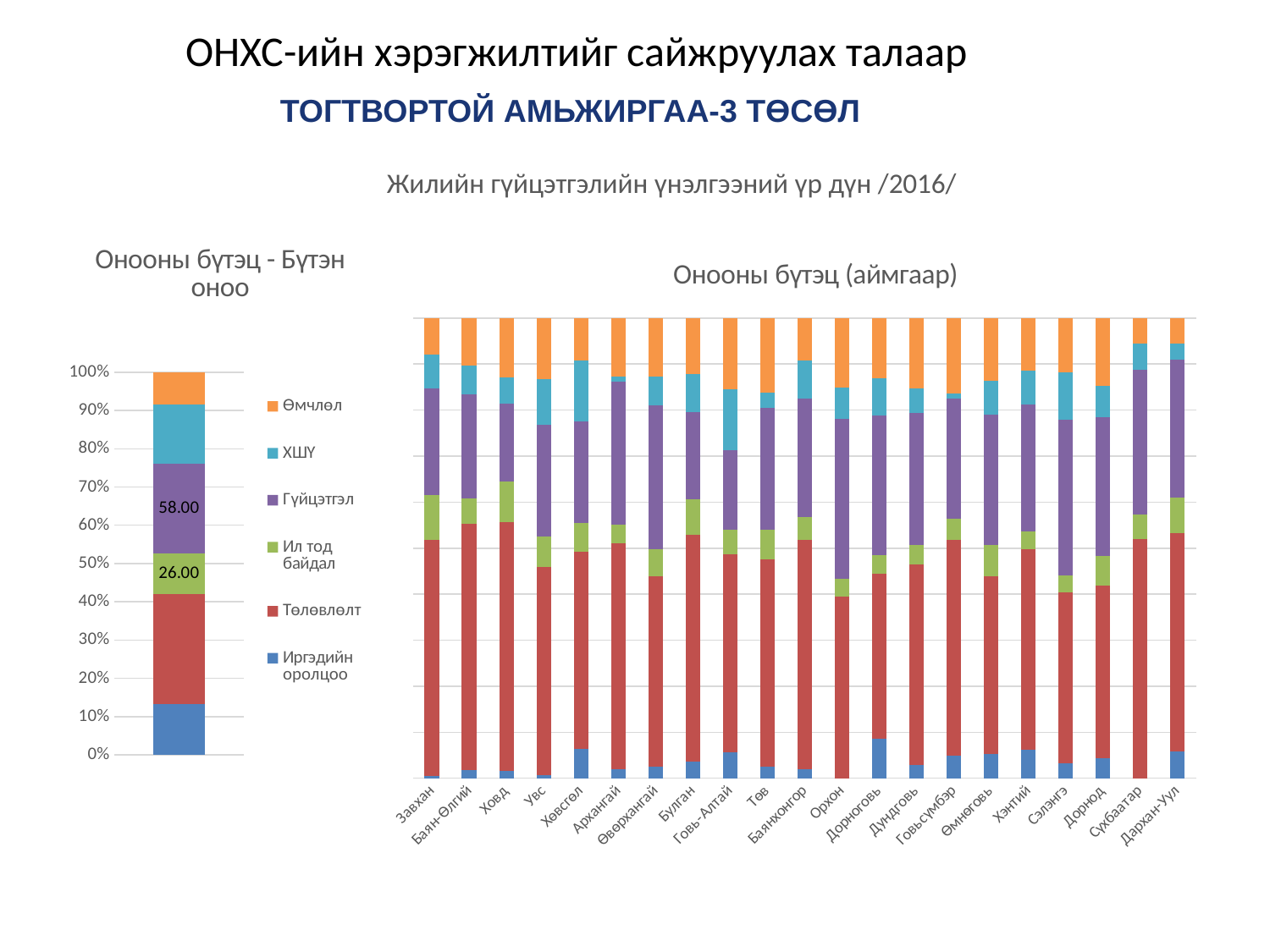
In the chart titled "Онооны бүтэц - Бүтэн оноо", what value is labelled on the Гүйцэтгэл segment? 58.00 In the chart titled "Онооны бүтэц - Бүтэн оноо", which legend entry is shown in orange? Өмчлөл What kind of chart is the chart titled "Онооны бүтэц (аймгаар)"? Stacked bar chart In the chart titled "Онооны бүтэц - Бүтэн оноо", which labelled segment is larger, Гүйцэтгэл or Ил тод байдал? Гүйцэтгэл In the chart titled "Онооны бүтэц - Бүтэн оноо", is the Иргэдийн оролцоо segment greater or less than 10%? greater How many series does the legend of the chart titled "Онооны бүтэц - Бүтэн оноо" list? 6 In the chart titled "Онооны бүтэц - Бүтэн оноо", what is the difference between the labelled Гүйцэтгэл value and the labelled Ил тод байдал value? 32.00 How many categories (aimags) are shown on the x axis of the chart titled "Онооны бүтэц (аймгаар)"? 21 In the chart titled "Онооны бүтэц (аймгаар)", what is the first category on the x axis? Завхан What kind of chart is the chart titled "Онооны бүтэц - Бүтэн оноо"? Stacked bar chart In the chart titled "Онооны бүтэц - Бүтэн оноо", what value is labelled on the Ил тод байдал segment? 26.00 What is the title of the chart on the right side of the slide? Онооны бүтэц (аймгаар)